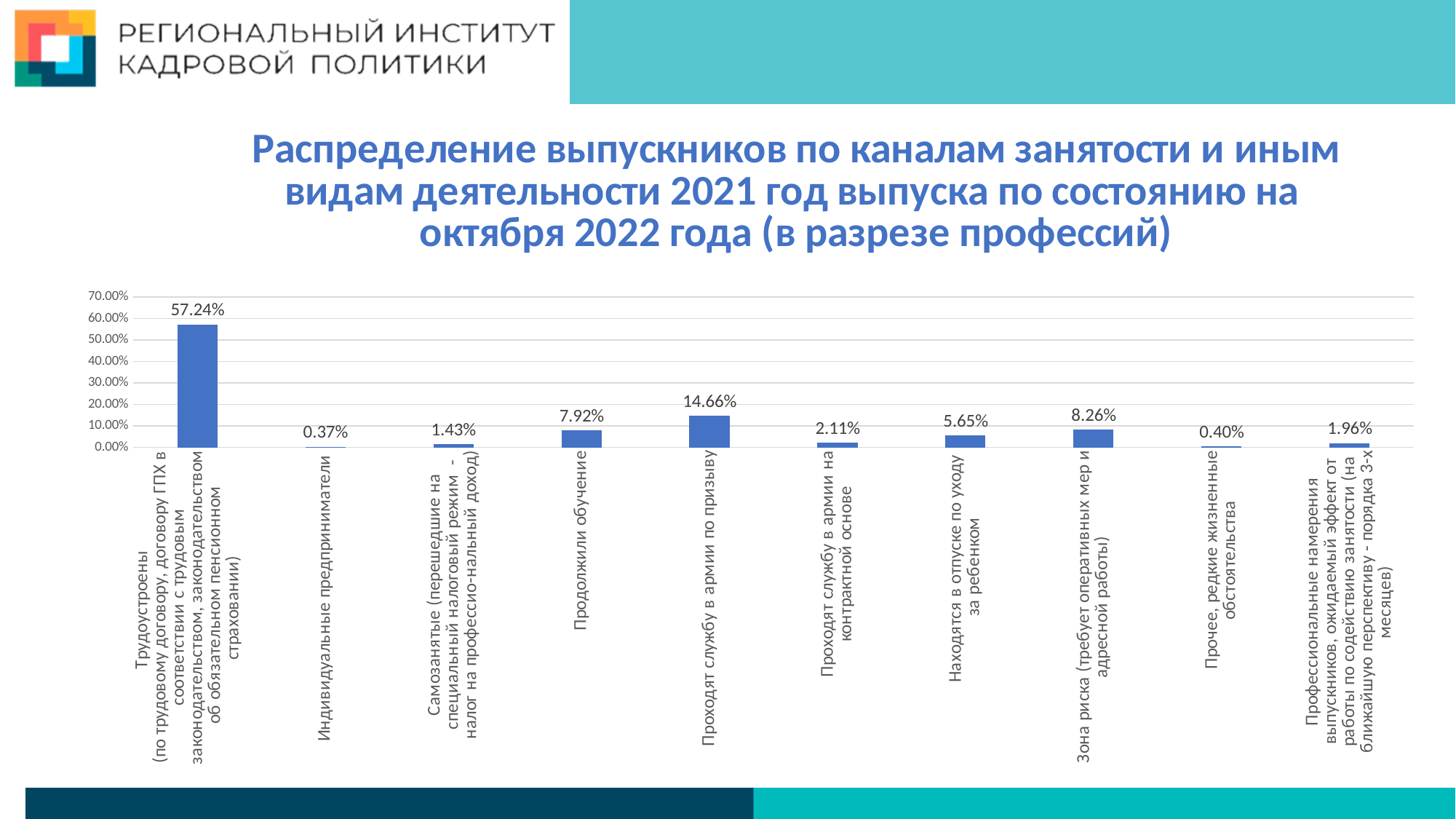
Which is larger: the value for "Находятся в отпуске по уходу за ребенком" or for "Проходят службу в армии на контрактной основе"? Находятся в отпуске по уходу за ребенком What percentage of graduates are shown as "Продолжили обучение"? 7.92% What kind of chart is shown on the slide? bar chart Which category has the highest value on the chart? Трудоустроены How many categories are plotted on the chart? 10 What is the difference between the values for "Проходят службу в армии по призыву" and "Проходят службу в армии на контрактной основе"? 12.55% Is the value for "Трудоустроены" greater or less than 50.00%? greater What is the highest value shown on the vertical axis of the chart? 70.00% Which category has the lowest value on the chart? Индивидуальные предприниматели What is the value for "Индивидуальные предприниматели"? 0.37% What is the value for "Проходят службу в армии по призыву"? 14.66% What is the difference between the values for "Зона риска" and "Продолжили обучение"? 0.34%